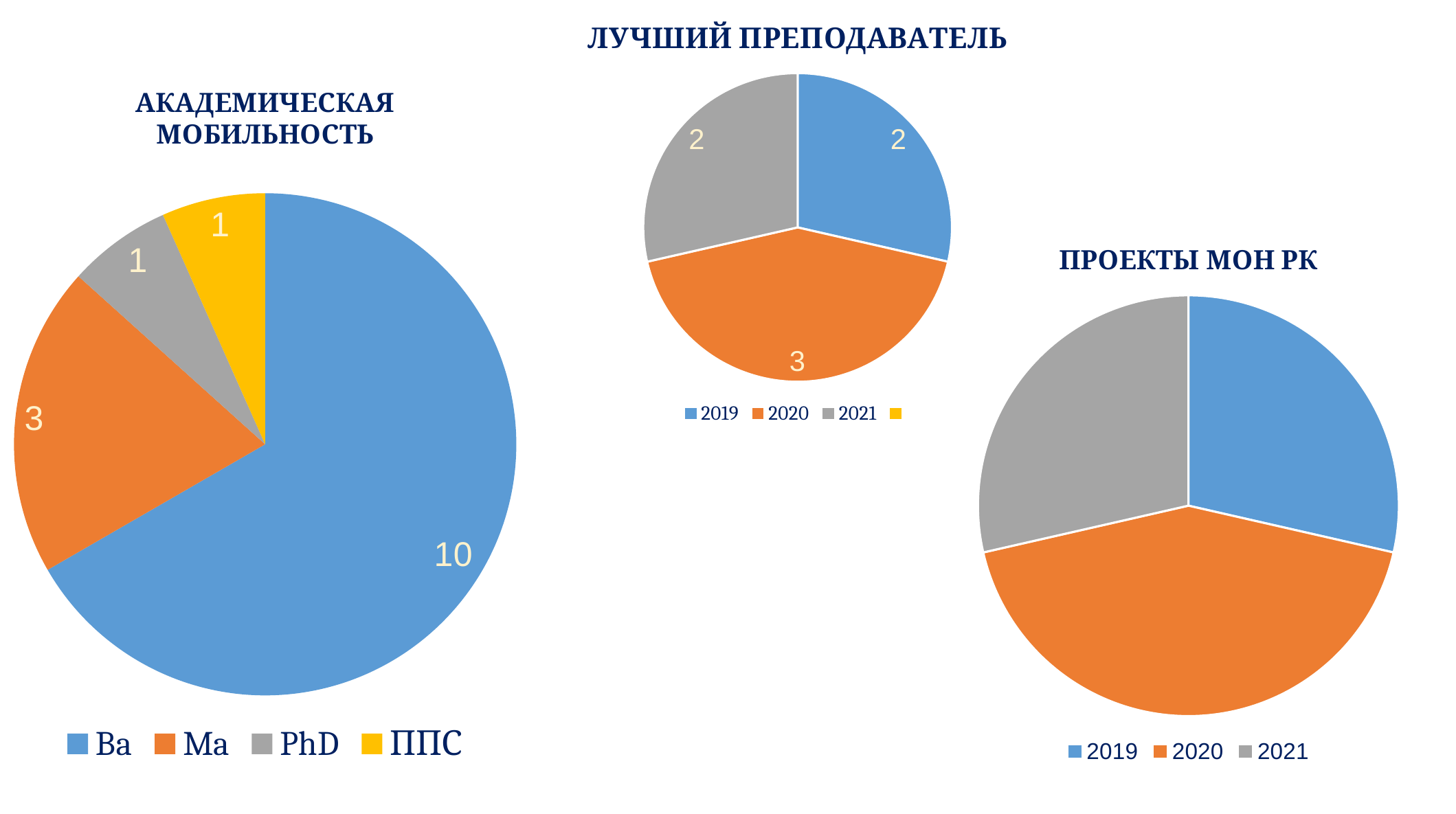
In the АКАДЕМИЧЕСКАЯ МОБИЛЬНОСТЬ chart, what is the value for Ba? 10 In the ЛУЧШИЙ ПРЕПОДАВАТЕЛЬ chart, what is the value for 2019? 2 In the ЛУЧШИЙ ПРЕПОДАВАТЕЛЬ chart, what is the value for 2020? 3 How many entries does the legend of the ПРОЕКТЫ МОН РК chart list? 3 In the АКАДЕМИЧЕСКАЯ МОБИЛЬНОСТЬ chart, what is the difference between the Ba and Ma values? 7 In the АКАДЕМИЧЕСКАЯ МОБИЛЬНОСТЬ chart, what is the value for Ma? 3 In the ЛУЧШИЙ ПРЕПОДАВАТЕЛЬ chart, which year has the largest slice? 2020 What type of chart is the ПРОЕКТЫ МОН РК chart? Pie chart How many categories does the АКАДЕМИЧЕСКАЯ МОБИЛЬНОСТЬ chart show? 4 In the ПРОЕКТЫ МОН РК chart, which year has the largest slice? 2020 In the АКАДЕМИЧЕСКАЯ МОБИЛЬНОСТЬ chart, what is the total of all slices? 15 In the АКАДЕМИЧЕСКАЯ МОБИЛЬНОСТЬ chart, which category has the largest slice? Ba